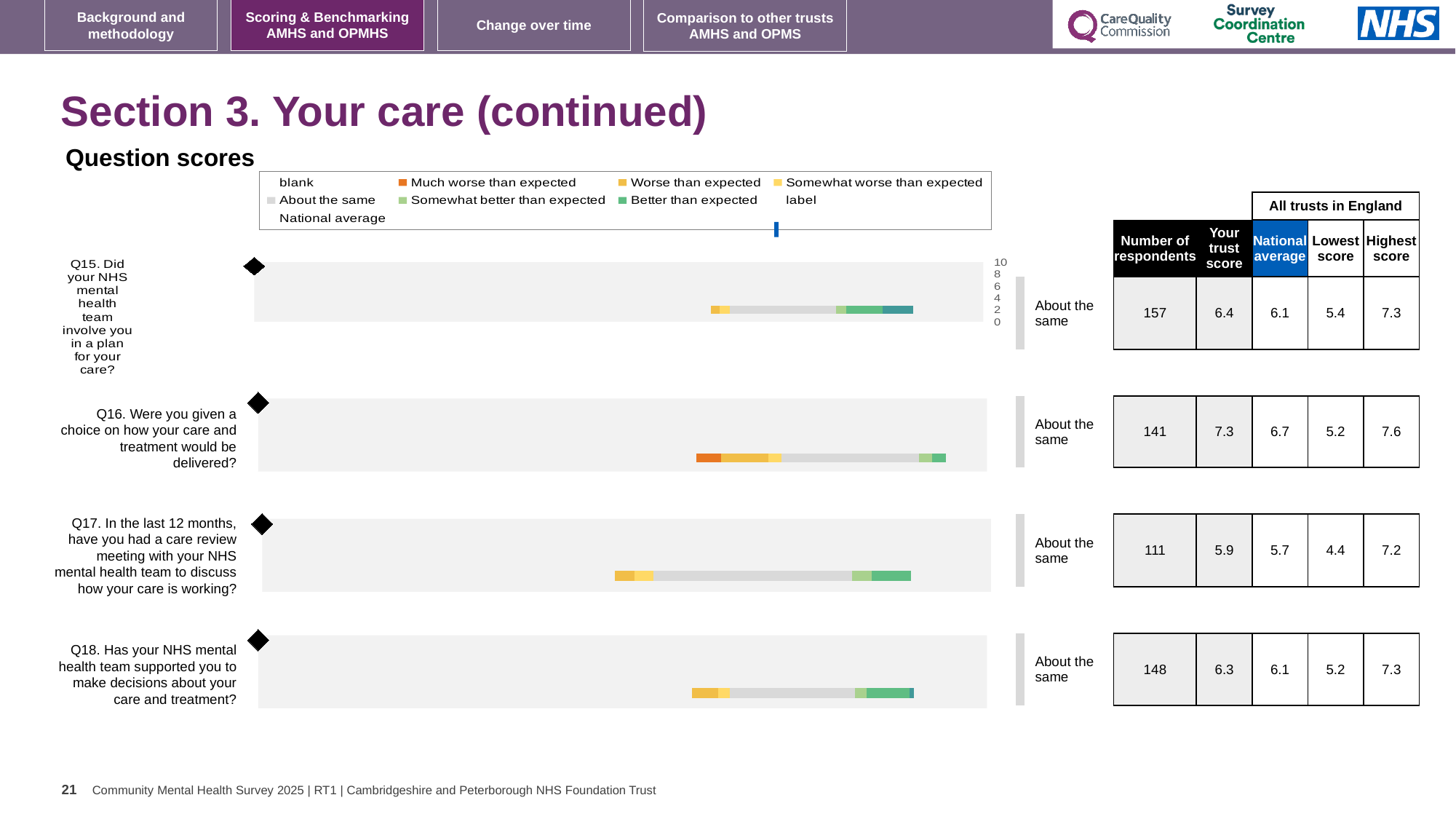
What is the national average score for Q15 (Did your NHS mental health team involve you in a plan for your care)? 6.1 What kind of chart is used to show the question scores for Q15 to Q18? bar chart For Q18, which is larger: the trust score or the national average? the trust score How many questions (Q15 to Q18) have a score bar plotted on the slide? 4 Which question has the lowest trust score? Q17 What benchmark label is shown next to the Q15 bar? About the same Which question has the highest trust score? Q16 What is the highest score across all trusts in England for Q18? 7.3 What is the lowest score across all trusts in England for Q17? 4.4 How many respondents answered Q17 (care review meeting in the last 12 months)? 111 What is the difference between the trust score and the national average for Q16? 0.6 What is the trust score for Q16 (Were you given a choice on how your care and treatment would be delivered)? 7.3